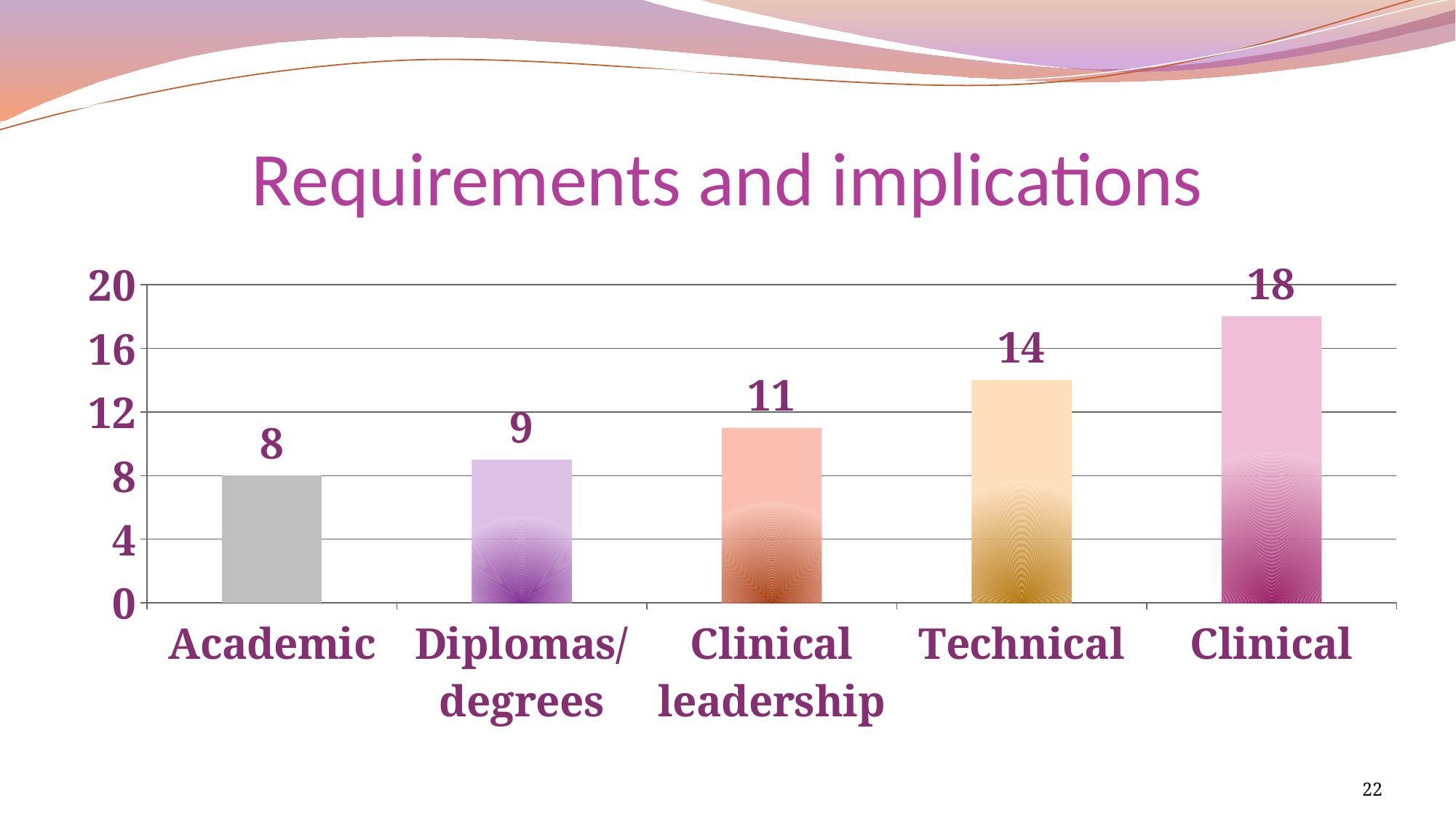
What is the difference between the values for Clinical and Academic? 10 What is the value for Technical? 14 What is the difference between the values for Technical and Clinical leadership? 3 Which is larger, the value for Technical or the value for Diplomas/degrees? Technical What is the value for Diplomas/degrees? 9 What is the value for Academic? 8 Do the values rise or fall from left to right along the x axis? Rise Which category has the lowest value? Academic How many categories are shown in the chart? 5 What kind of chart is shown on the slide? Bar chart What is the value for Clinical leadership? 11 Which category has the highest value? Clinical